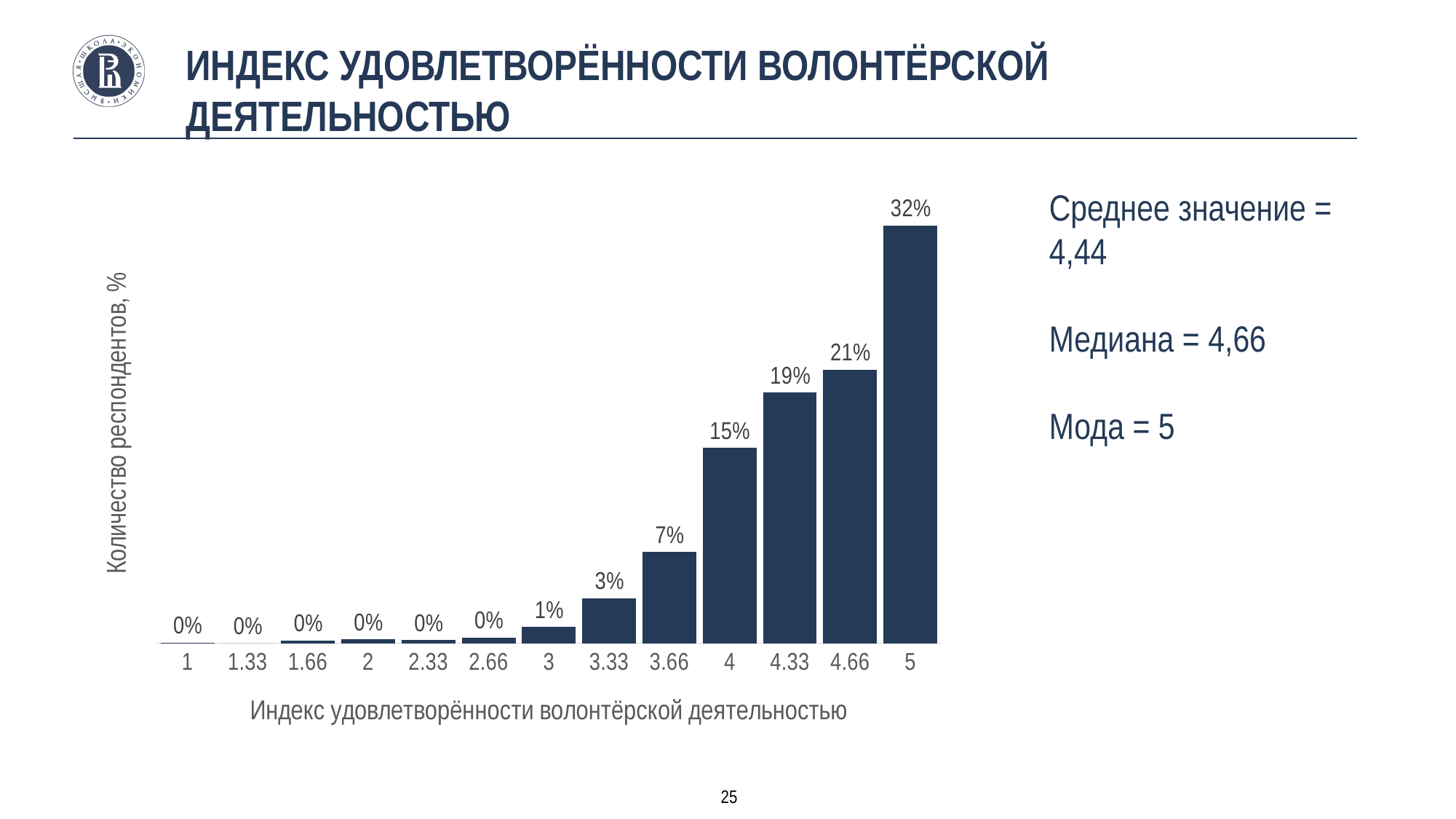
Which has a larger share of respondents: index 4.33 or index 3.66? 4.33 What percentage of respondents have a satisfaction index of 3.33? 3% What percentage of respondents have a satisfaction index of 3.66? 7% Which satisfaction index value has the highest share of respondents? 5 What is the difference in percentage points between the share of respondents at index 5 and at index 4.66? 11% How many index categories are shown on the x axis? 13 What is the difference in percentage points between the share of respondents at index 4.33 and at index 4? 4% What is the label of the y axis? Количество респондентов, % What kind of chart is shown on the slide? Bar chart What percentage of respondents have a satisfaction index of 4? 15% What percentage of respondents have a satisfaction index of 5? 32% Do the values generally rise or fall as the satisfaction index increases along the x axis? Rise